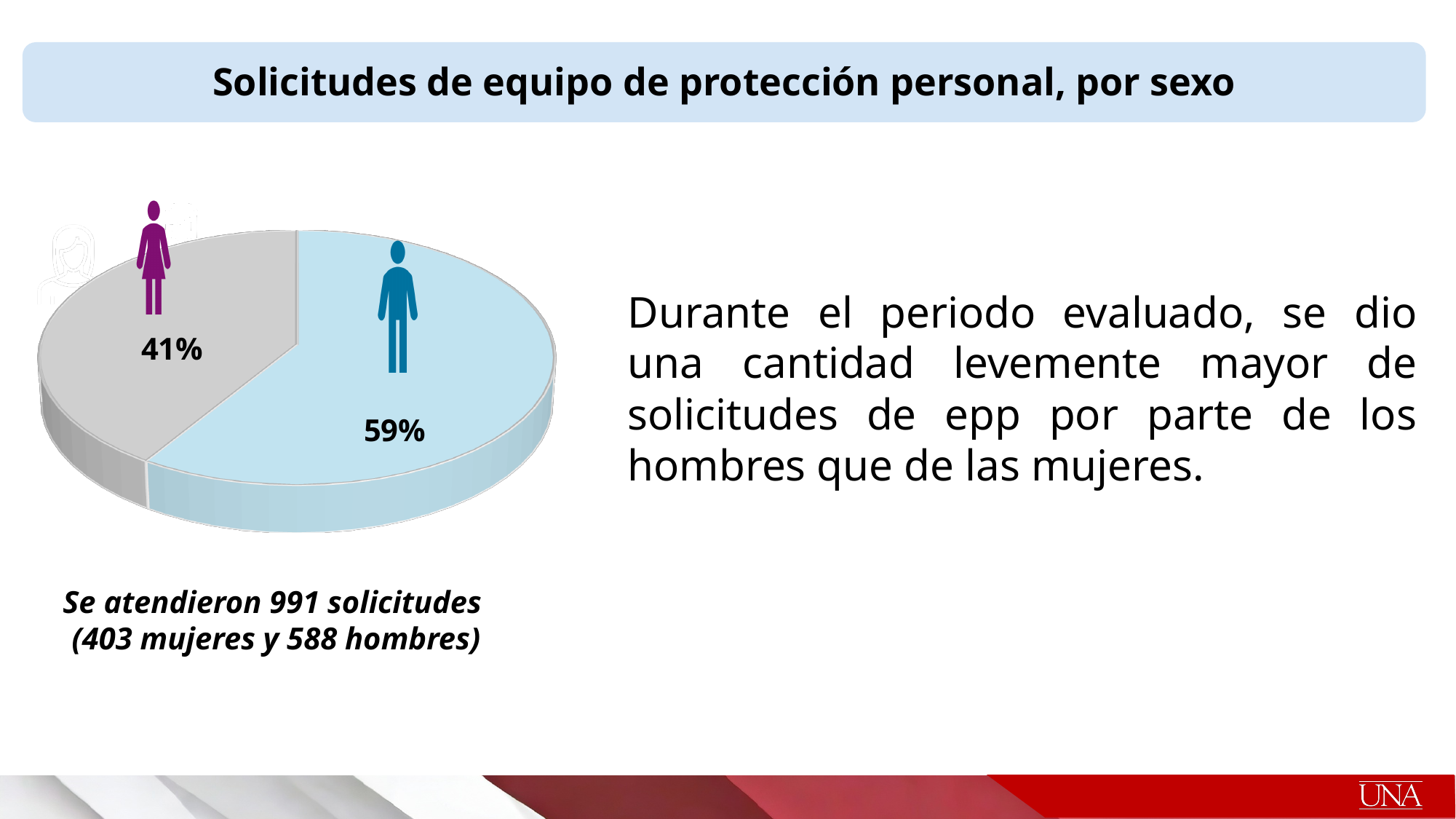
Which group has the largest slice of the pie chart? Men (hombres) What share of the pie chart corresponds to men (hombres)? 59% Is the men's share of the pie chart greater or less than 50%? greater Is the women's share of the pie chart greater or less than 50%? less How many slices does the pie chart have? 2 Which group has the larger slice of the pie chart, men or women? Men (hombres) What is the title of the slide containing the chart? Solicitudes de equipo de protección personal, por sexo What share of the pie chart corresponds to women (mujeres)? 41% What is the difference in percentage points between the men's slice and the women's slice? 18 percentage points What kind of chart is shown on the slide? Pie chart Which group has the smallest slice of the pie chart? Women (mujeres) What colour is the slice representing men in the pie chart? Light blue